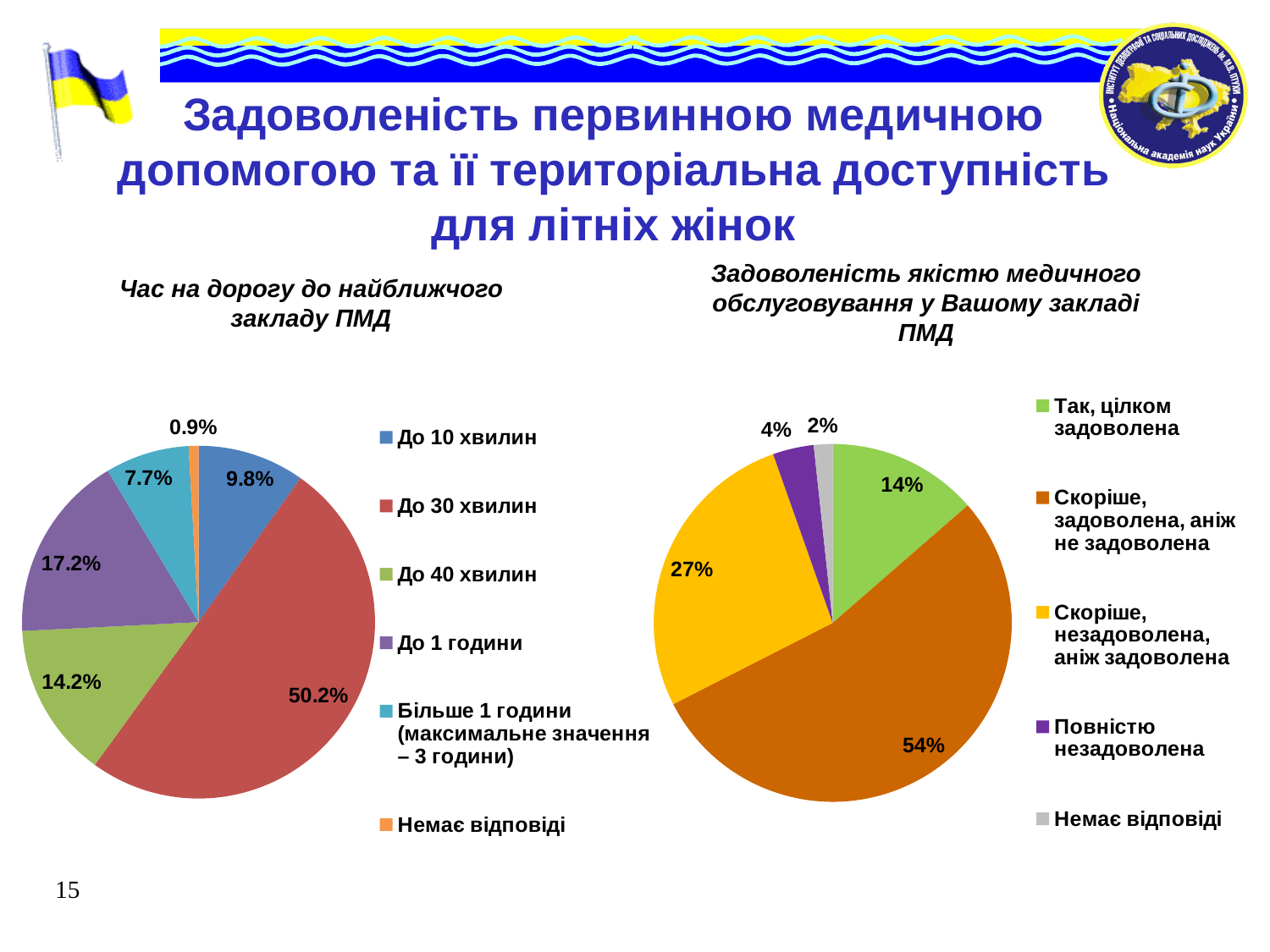
In the right chart 'Задоволеність якістю медичного обслуговування у Вашому закладі ПМД', which is larger: 'Так, цілком задоволена' or 'Повністю незадоволена'? Так, цілком задоволена What type of chart is used for 'Задоволеність якістю медичного обслуговування у Вашому закладі ПМД'? Pie chart In the left chart 'Час на дорогу до найближчого закладу ПМД', what is the difference between the shares for 'До 1 години' and 'До 40 хвилин'? 3.0% In the left chart 'Час на дорогу до найближчого закладу ПМД', how many categories does the legend list? 6 In the right chart 'Задоволеність якістю медичного обслуговування у Вашому закладі ПМД', what colour is the slice for 'Немає відповіді'? Grey In the left chart 'Час на дорогу до найближчого закладу ПМД', which category has the largest slice? До 30 хвилин In the right chart 'Задоволеність якістю медичного обслуговування у Вашому закладі ПМД', which category has the largest slice? Скоріше, задоволена, аніж не задоволена In the left chart 'Час на дорогу до найближчого закладу ПМД', what share is labelled for 'До 1 години'? 17.2% In the left chart 'Час на дорогу до найближчого закладу ПМД', what share is labelled for 'До 30 хвилин'? 50.2% In the left chart 'Час на дорогу до найближчого закладу ПМД', which category has the smallest slice? Немає відповіді In the right chart 'Задоволеність якістю медичного обслуговування у Вашому закладі ПМД', what is the difference between the shares for 'Скоріше, задоволена, аніж не задоволена' and 'Так, цілком задоволена'? 40% In the right chart 'Задоволеність якістю медичного обслуговування у Вашому закладі ПМД', what share is labelled for 'Скоріше, незадоволена, аніж задоволена'? 27%